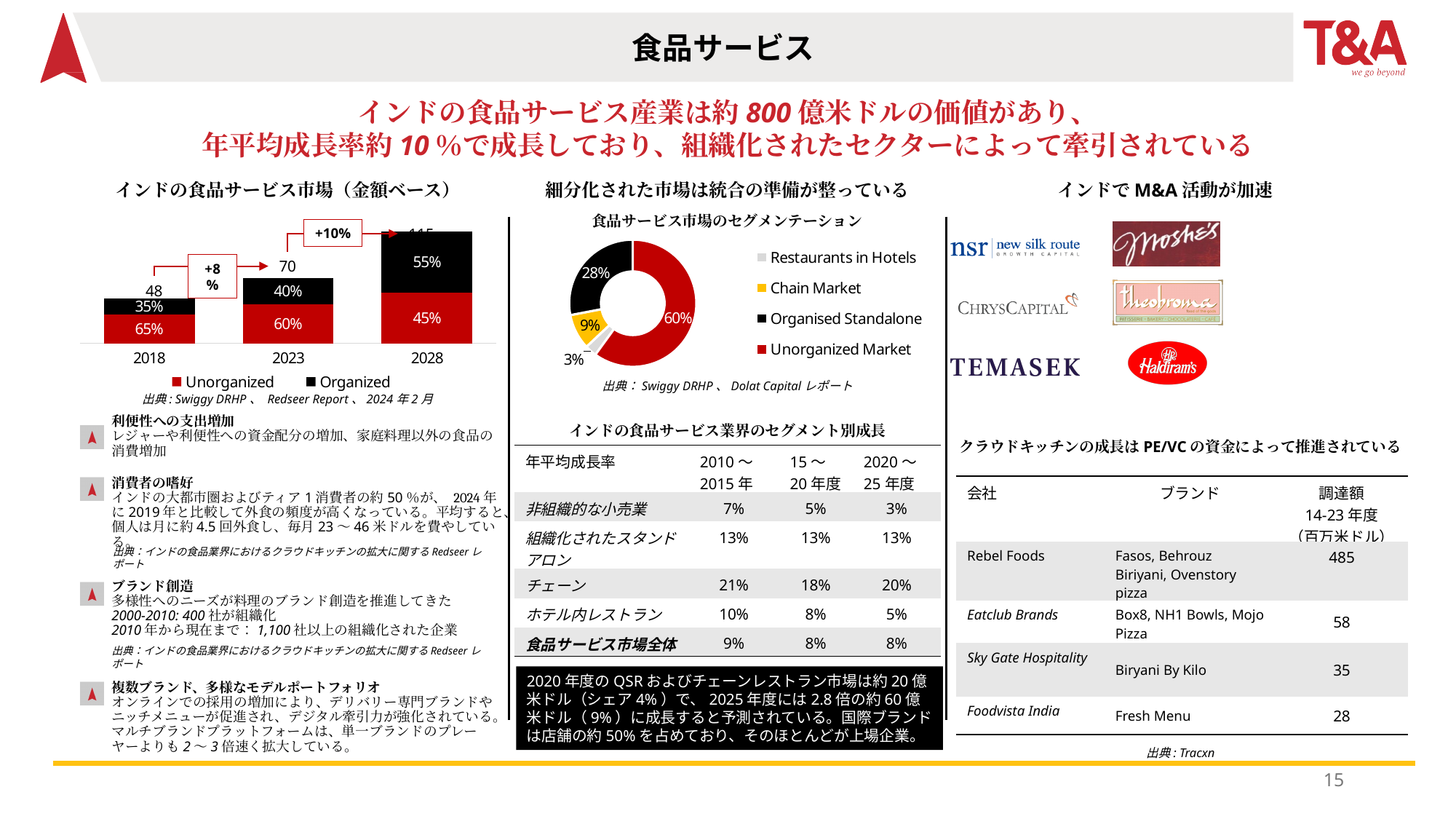
In the stacked bar chart titled インドの食品サービス市場（金額ベース）, does the Organized share rise or fall from 2018 to 2028? rise In the stacked bar chart titled インドの食品サービス市場（金額ベース）, how many series does the legend list? 2 In the doughnut chart titled 食品サービス市場のセグメンテーション, which segment has the smallest share? Restaurants in Hotels In the doughnut chart titled 食品サービス市場のセグメンテーション, which is larger, Chain Market or Organised Standalone? Organised Standalone In the stacked bar chart titled インドの食品サービス市場（金額ベース）, what is the total value shown above the 2023 bar? 70 In the stacked bar chart titled インドの食品サービス市場（金額ベース）, what is the Unorganized share for 2018? 65% In the stacked bar chart titled インドの食品サービス市場（金額ベース）, what growth rate is shown between 2023 and 2028? +10% In the stacked bar chart titled インドの食品サービス市場（金額ベース）, how many years are shown on the x axis? 3 In the doughnut chart titled 食品サービス市場のセグメンテーション, what is the share of Organised Standalone? 28% In the stacked bar chart titled インドの食品サービス市場（金額ベース）, what is the difference between the Unorganized and Organized shares in 2023? 20% In the stacked bar chart titled インドの食品サービス市場（金額ベース）, what is the Organized share for 2028? 55% What kind of chart is the 食品サービス市場のセグメンテーション chart? doughnut chart